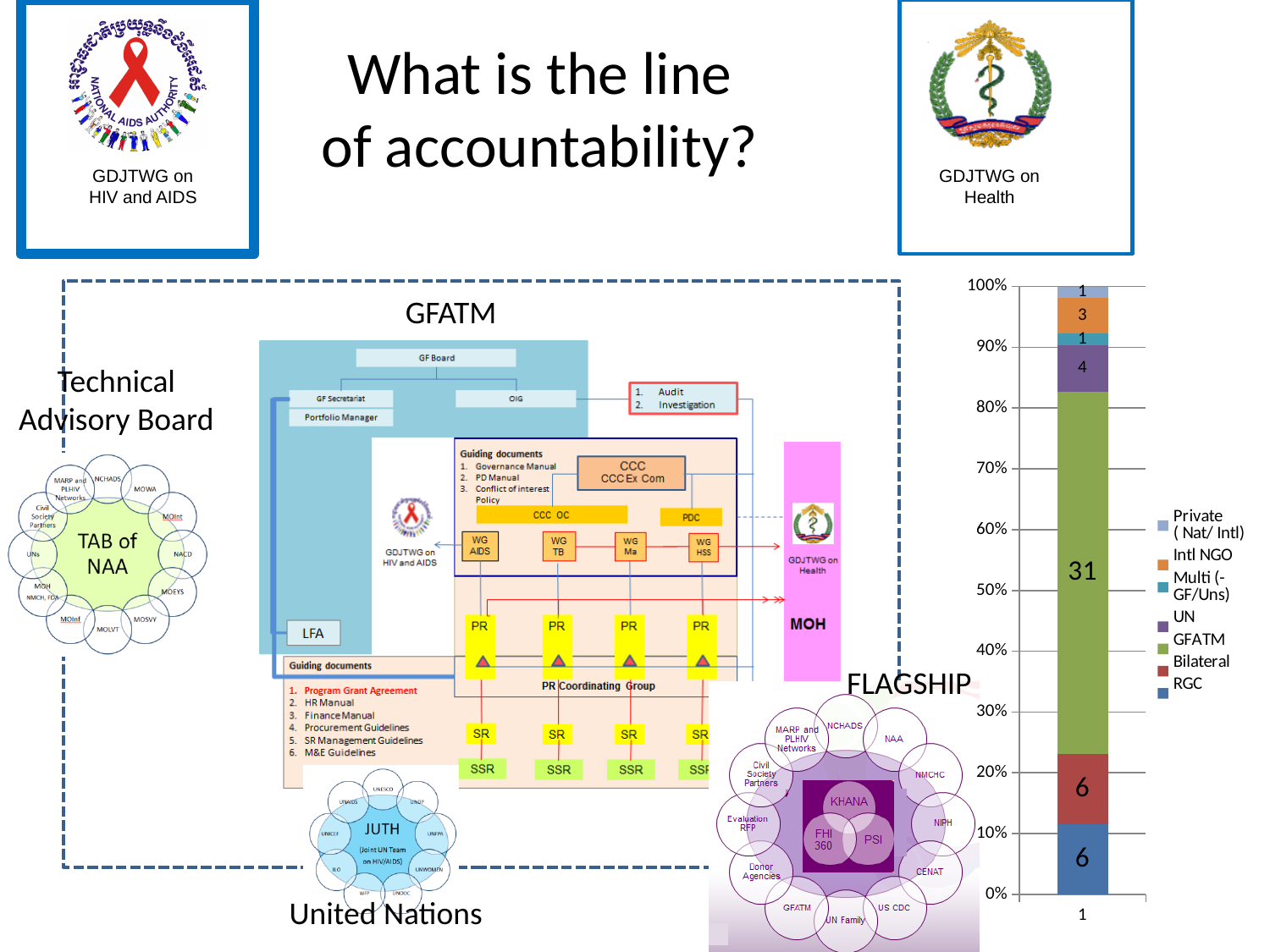
What is the total of all the segment values in the stacked bar? 52 How many series does the legend of the stacked bar chart list? 7 How many bars are plotted in the stacked bar chart? 1 In the stacked bar chart, what is the difference between the GFATM value and the UN value? 27 In the stacked bar chart, what is the value labelled for the Intl NGO segment? 3 In the stacked bar chart, what is the value labelled for the RGC segment? 6 Which series has the largest segment in the stacked bar chart? GFATM What type of chart is shown on the right side of the slide? stacked bar chart In the stacked bar chart, what is the value labelled for the Bilateral segment? 6 In the stacked bar chart, what is the value labelled for the GFATM segment? 31 In the stacked bar chart, which is larger, the GFATM segment or the Bilateral segment? GFATM In the stacked bar chart, what is the value labelled for the UN segment? 4